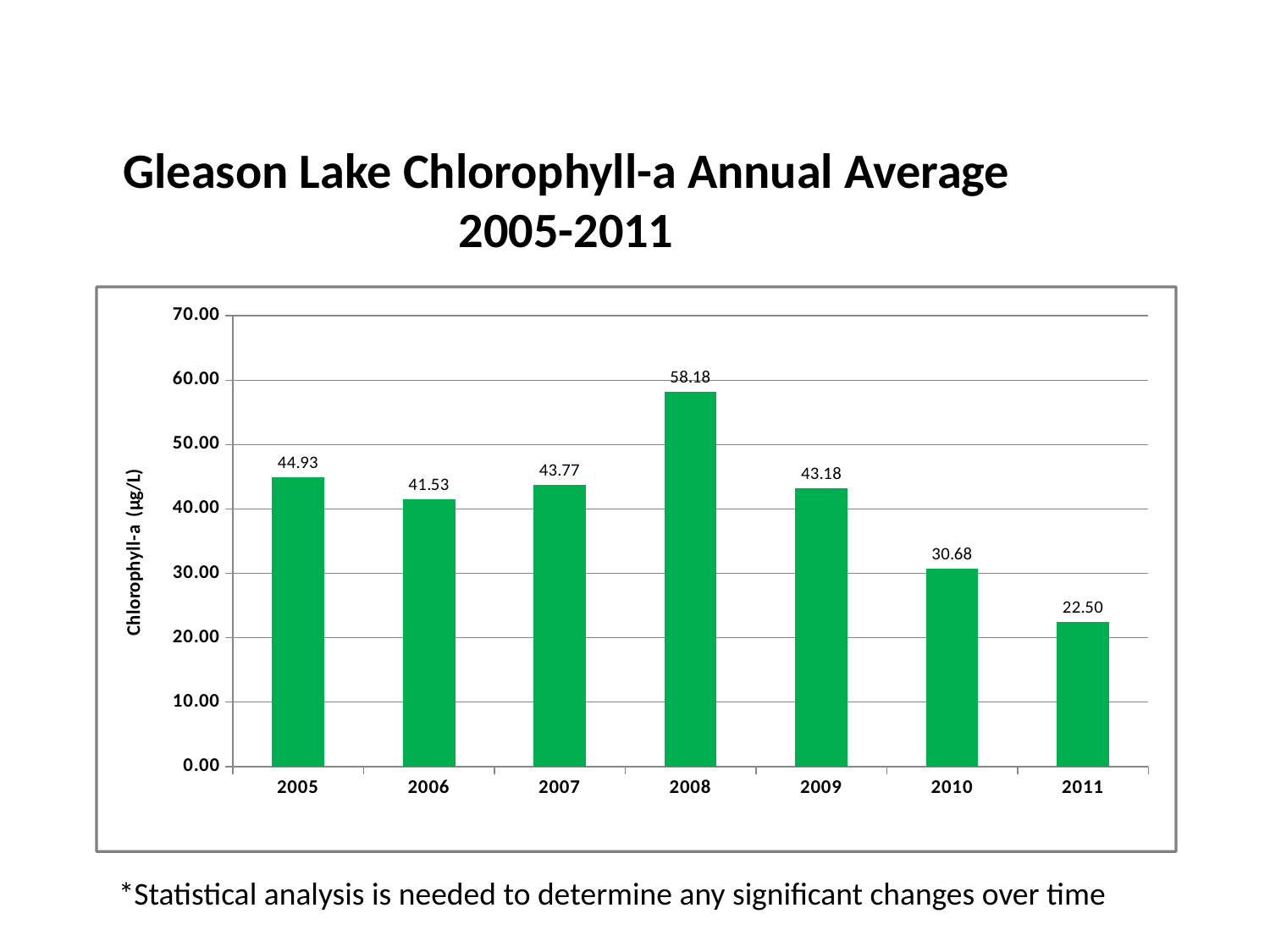
How many years are shown on the chart? 7 Which year has the highest chlorophyll-a annual average? 2008 Is the chlorophyll-a annual average for 2010 greater or less than 40.00? less What is the difference between the 2008 and 2011 chlorophyll-a annual averages? 35.68 What is the chlorophyll-a annual average for 2011? 22.50 What kind of chart is shown on the slide? bar chart Which year has a higher chlorophyll-a annual average, 2009 or 2010? 2009 What is the chlorophyll-a annual average for 2006? 41.53 What is the chlorophyll-a annual average for 2008? 58.18 What is the label of the y axis? Chlorophyll-a (µg/L) What is the difference between the 2005 and 2006 chlorophyll-a annual averages? 3.40 Which year has the lowest chlorophyll-a annual average? 2011